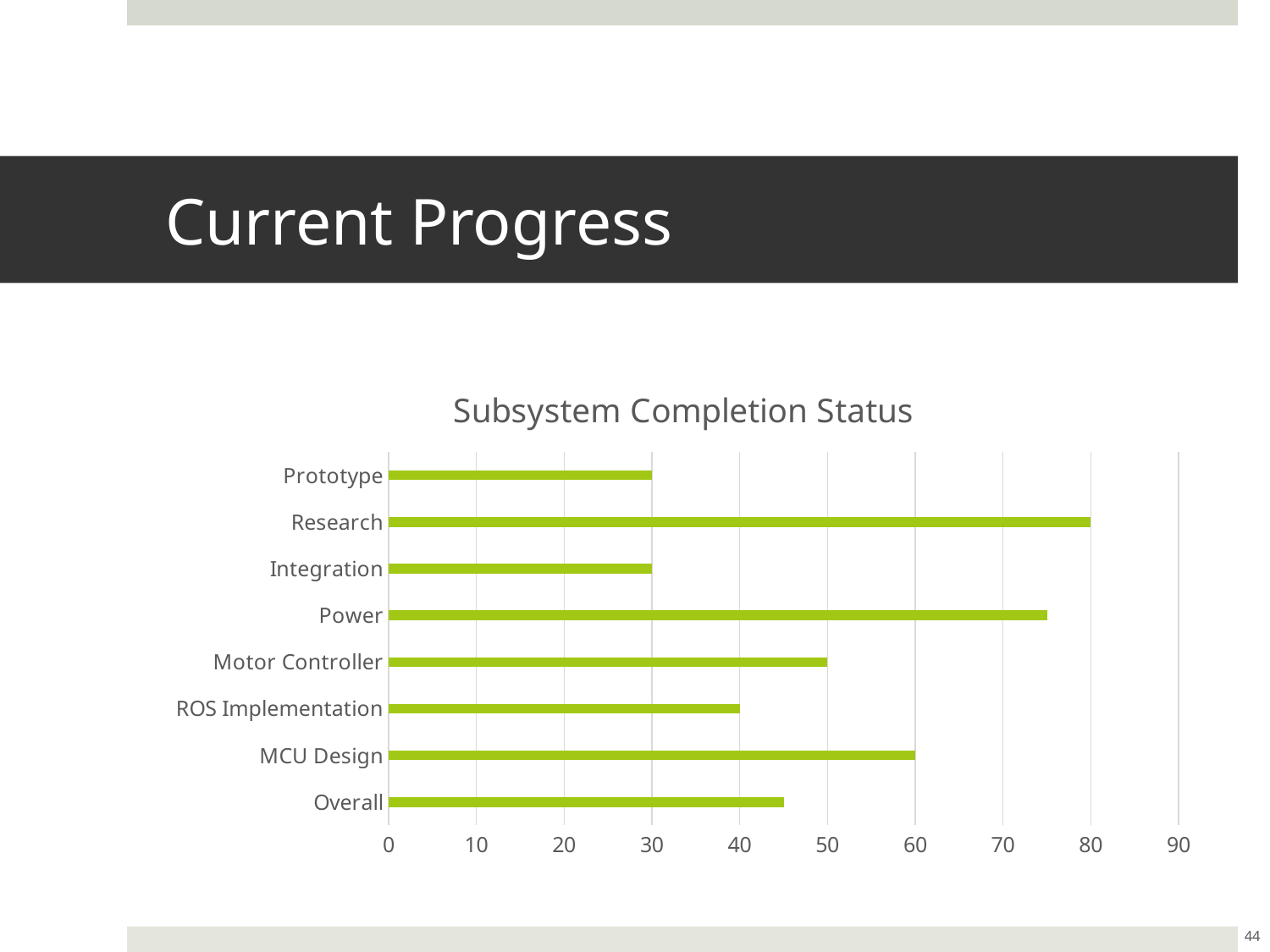
What type of chart is shown on the slide? bar chart What is the value for Research? 80 What is the value for Motor Controller? 50 What is the difference between the values for Research and Motor Controller? 30 What is the title of the chart? Subsystem Completion Status Is the value for Power greater or less than 70? greater What is the value for Prototype? 30 Which category has the highest value? Research Which is larger, the value for MCU Design or the value for ROS Implementation? MCU Design How many categories are plotted in the chart? 8 What is the value for MCU Design? 60 What is the value for ROS Implementation? 40